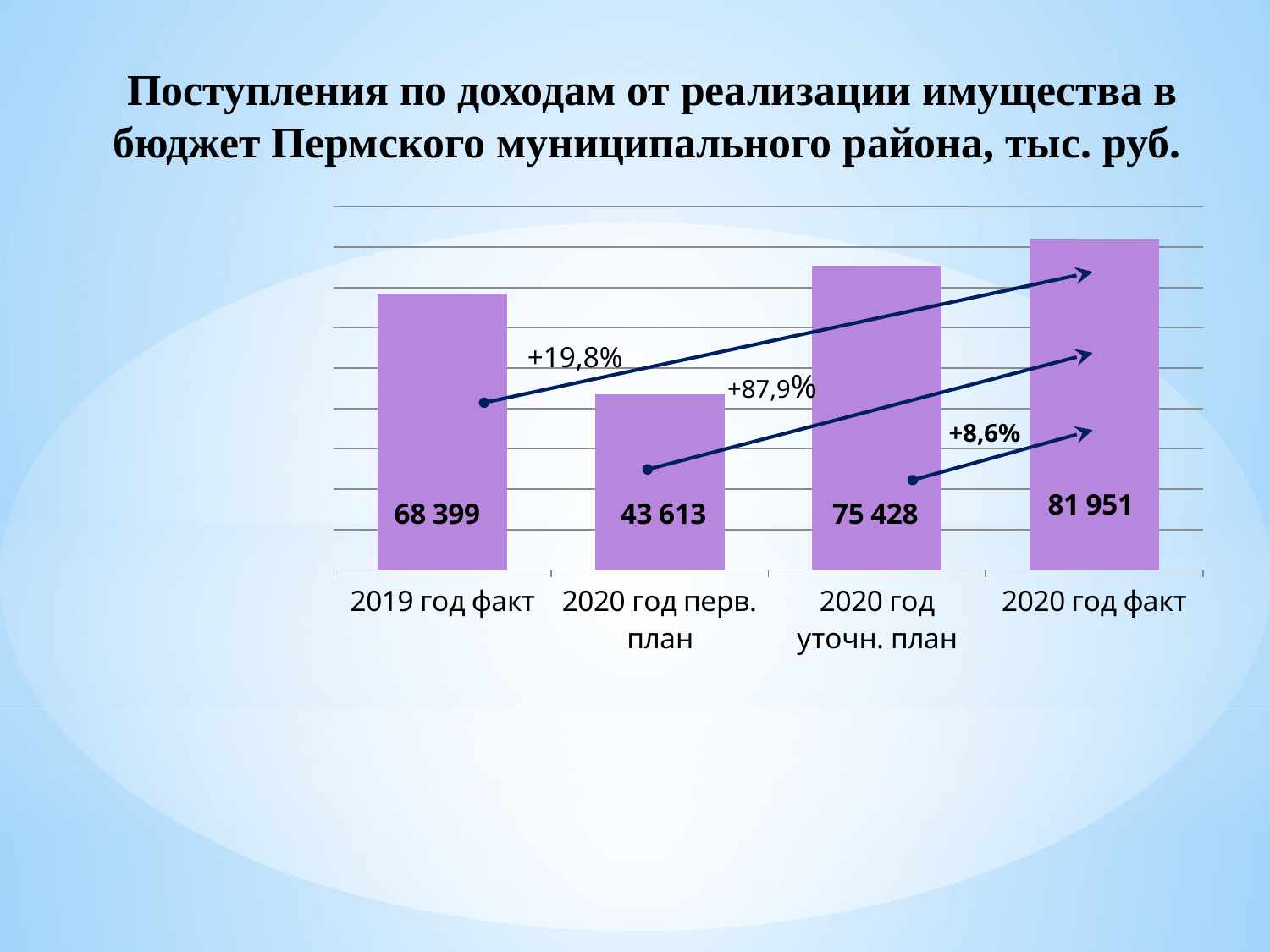
How many categories are shown on the chart? 4 Which is larger, the value for 2019 год факт or the value for 2020 год уточн. план? 2020 год уточн. план What is the value for 2020 год уточн. план? 75 428 What is the value for 2020 год перв. план? 43 613 What is the value for 2019 год факт? 68 399 What is the value for 2020 год факт? 81 951 What kind of chart is shown on the slide? Bar chart Which category has the lowest value? 2020 год перв. план What percentage change is annotated between 2020 год уточн. план and 2020 год факт? +8,6% Which category has the highest value? 2020 год факт What is the difference between the values for 2020 год уточн. план and 2020 год перв. план? 31 815 What is the difference between the values for 2020 год факт and 2019 год факт? 13 552